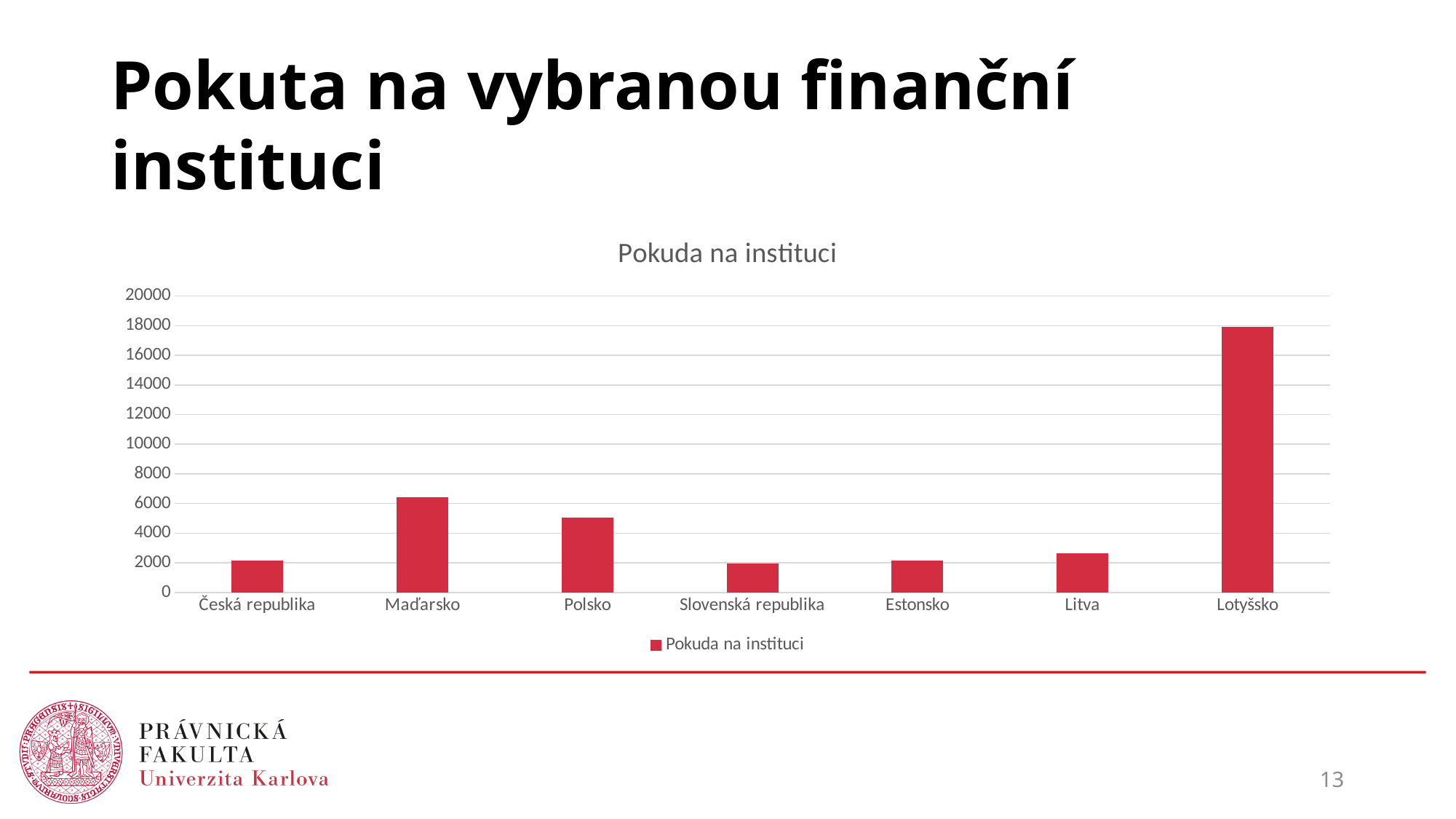
What is the name of the series shown in the chart legend? Pokuda na instituci Which has the larger value, Litva or Lotyšsko? Lotyšsko Is the value for Česká republika greater or less than 4000? less Is the value for Polsko greater or less than 4000? greater Which country has the highest value in the chart? Lotyšsko Which has the larger value, Maďarsko or Polsko? Maďarsko How many countries are shown on the x axis of the chart? 7 Is the value for Lotyšsko greater or less than 16000? greater How many series does the chart legend list? 1 What kind of chart is shown on the slide? bar chart What is the title of the chart? Pokuda na instituci